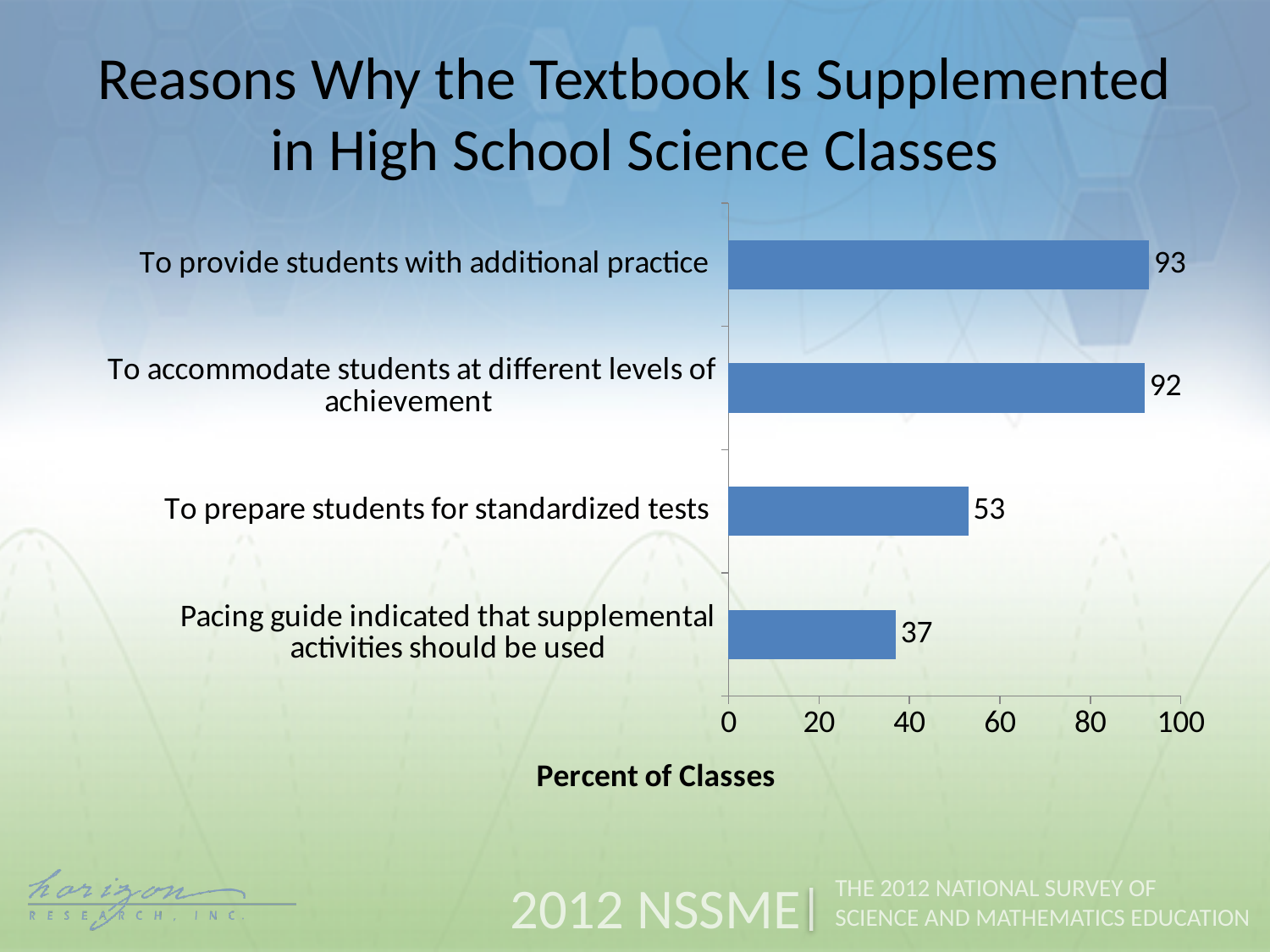
Which has a higher percent of classes: 'To prepare students for standardized tests' or 'Pacing guide indicated that supplemental activities should be used'? To prepare students for standardized tests What percent of classes supplement the textbook to prepare students for standardized tests? 53 How many reasons for supplementing the textbook are shown in the chart? 4 What is the label of the horizontal axis of the chart? Percent of Classes What kind of chart is shown on the slide? Bar chart Which reason for supplementing the textbook has the highest percent of classes? To provide students with additional practice What is the difference in percent of classes between 'To provide students with additional practice' and 'To prepare students for standardized tests'? 40 What percent of classes supplement the textbook because the pacing guide indicated that supplemental activities should be used? 37 Which reason for supplementing the textbook has the lowest percent of classes? Pacing guide indicated that supplemental activities should be used What percent of classes supplement the textbook to provide students with additional practice? 93 What is the difference in percent of classes between 'To prepare students for standardized tests' and 'Pacing guide indicated that supplemental activities should be used'? 16 What percent of classes supplement the textbook to accommodate students at different levels of achievement? 92